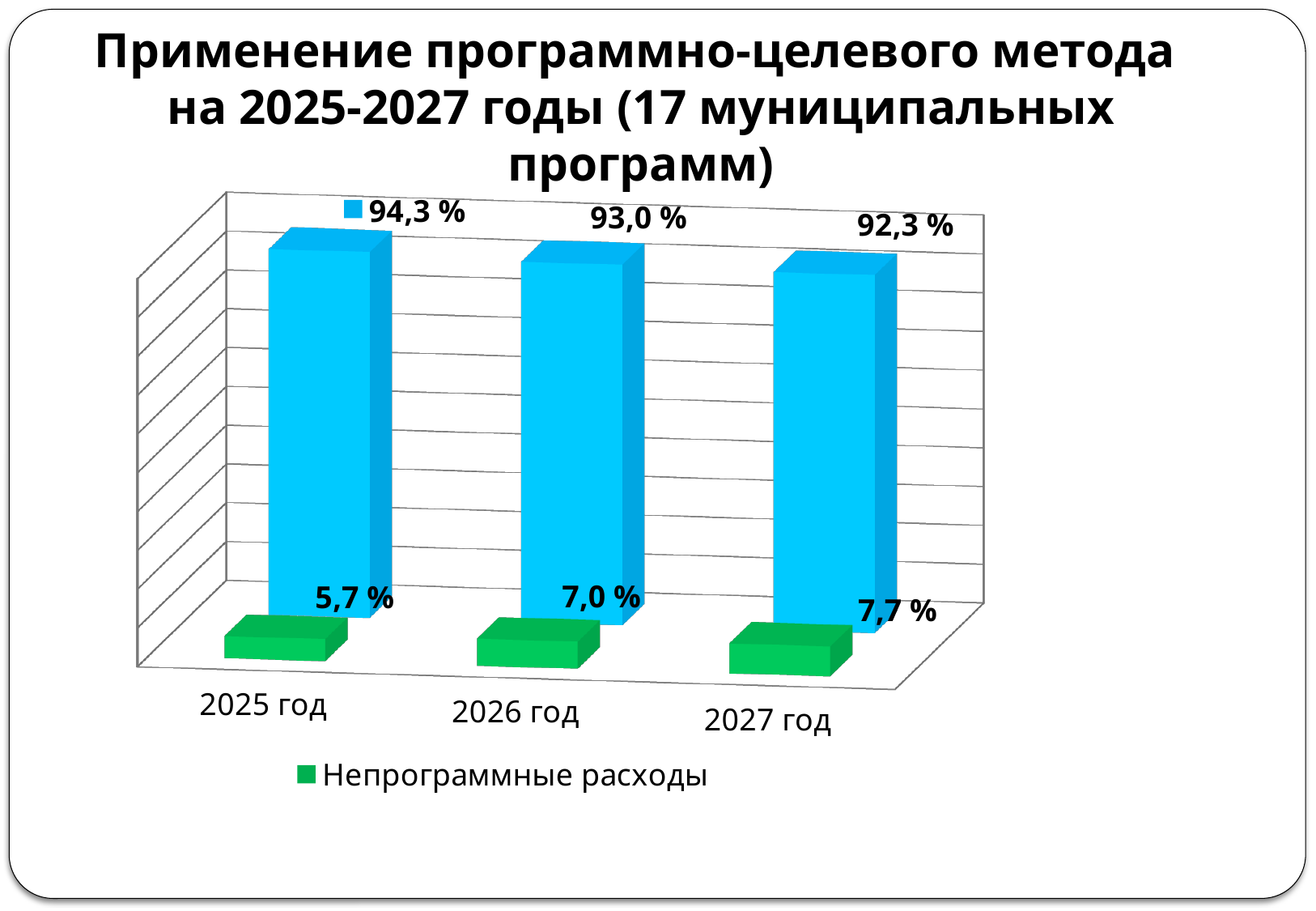
In which year is the value for Непрограммные расходы lowest? 2025 год What is the difference between the blue bar values for 2025 год and 2027 год? 2,0 % What is the value for Непрограммные расходы in 2027 год? 7,7 % Which is larger: the blue bar for 2026 год or the blue bar for 2027 год? 2026 год In which year is the blue bar highest? 2025 год What is the value for Непрограммные расходы in 2026 год? 7,0 % What is the value of the blue bar for 2027 год? 92,3 % How many years are shown on the x axis? 3 What is the difference between the Непрограммные расходы values for 2027 год and 2025 год? 2,0 % What kind of chart is shown on the slide? Bar chart What is the value of the blue bar for 2025 год? 94,3 % Do the values for Непрограммные расходы rise or fall from 2025 год to 2027 год? Rise